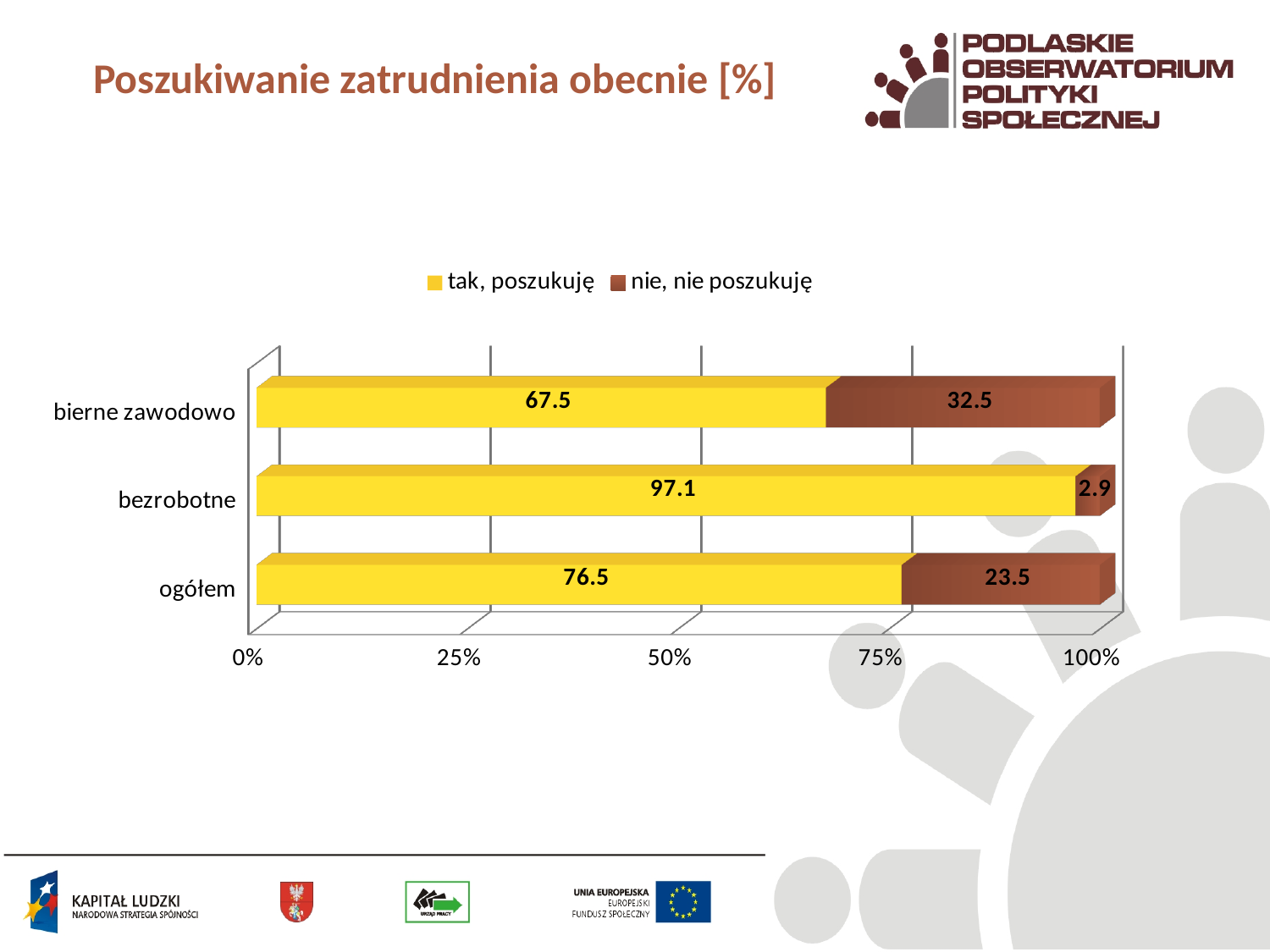
Which category has the highest value for "tak, poszukuję"? bezrobotne What is the value for "nie, nie poszukuję" in the "bierne zawodowo" category? 32.5 What is the difference between the "tak, poszukuję" values for "bezrobotne" and "ogółem"? 20.6 Which is larger: the "nie, nie poszukuję" value for "bierne zawodowo" or for "ogółem"? bierne zawodowo How many series does the legend list? 2 What is the total of the stacked bar for "ogółem"? 100 Which category has the lowest value for "nie, nie poszukuję"? bezrobotne What kind of chart is shown on the slide? stacked bar chart How many categories are shown on the chart? 3 What is the value for "tak, poszukuję" in the "ogółem" category? 76.5 What is the title of the chart? Poszukiwanie zatrudnienia obecnie [%] What is the value for "tak, poszukuję" in the "bezrobotne" category? 97.1